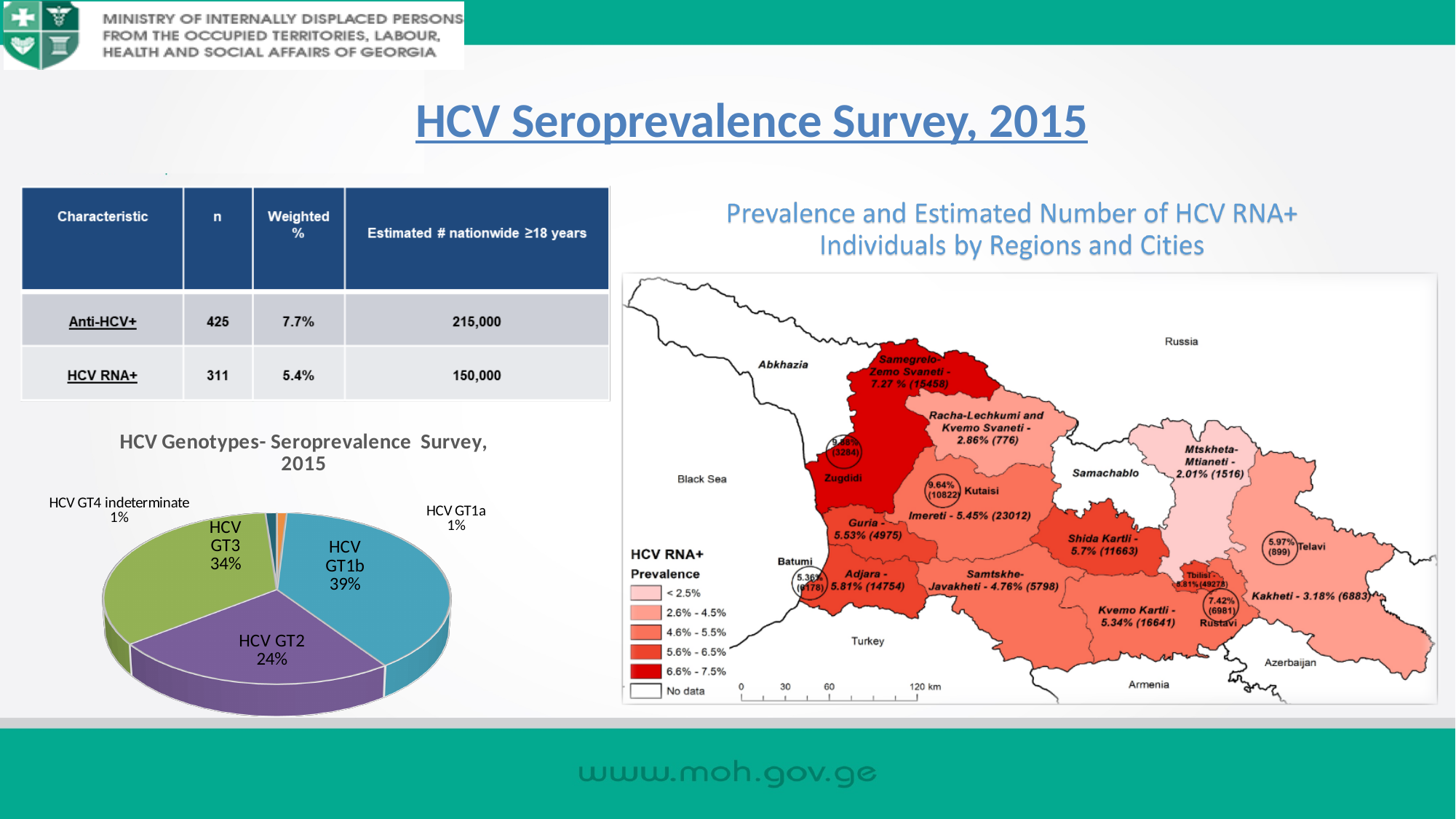
What is the title of the pie chart on the slide? HCV Genotypes- Seroprevalence Survey, 2015 In the HCV Genotypes pie chart, which is larger, HCV GT3 or HCV GT2? HCV GT3 How many slices does the HCV Genotypes pie chart have? 5 In the HCV Genotypes pie chart, what share does HCV GT4 indeterminate have? 1% What type of chart is the 'HCV Genotypes- Seroprevalence Survey, 2015' chart? Pie chart In the HCV Genotypes pie chart, what share does HCV GT2 have? 24% In the HCV Genotypes pie chart, what is the difference in percentage points between HCV GT1b and HCV GT2? 15 In the HCV Genotypes pie chart, what is the difference in percentage points between HCV GT3 and HCV GT2? 10 In the HCV Genotypes pie chart, what share does HCV GT1a have? 1% In the HCV Genotypes pie chart, which genotype has the largest share? HCV GT1b